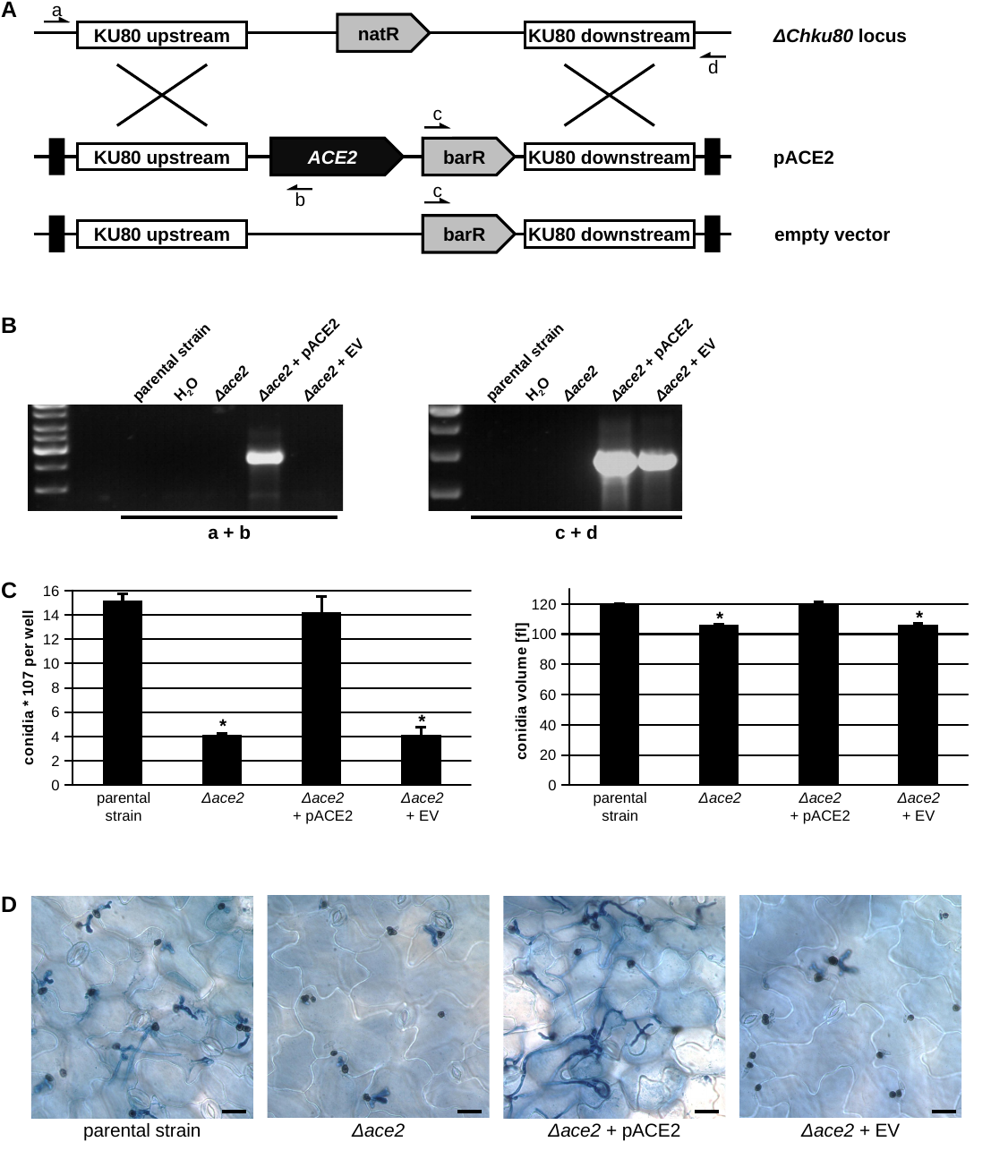
In the left chart of panel C (conidia * 10^7 per well), is the value for the parental strain greater or less than 12? greater In the left chart of panel C (conidia * 10^7 per well), is the value for Δace2 + EV greater or less than 8? less How many categories are shown on the x axis of the right chart in panel C (conidia volume [fl])? 4 In the right chart of panel C (conidia volume [fl]), is the value for the parental strain greater or less than 100? greater In the left chart of panel C (conidia * 10^7 per well), which is larger, the parental strain or Δace2? parental strain In the right chart of panel C (conidia volume [fl]), which is larger, the parental strain or Δace2 + EV? parental strain What kind of chart is the left chart in panel C? bar chart How many categories are shown on the x axis of the left chart in panel C (conidia * 10^7 per well)? 4 In the left chart of panel C (conidia * 10^7 per well), which is larger, Δace2 + pACE2 or Δace2 + EV? Δace2 + pACE2 What is the y-axis label of the right chart in panel C? conidia volume [fl]